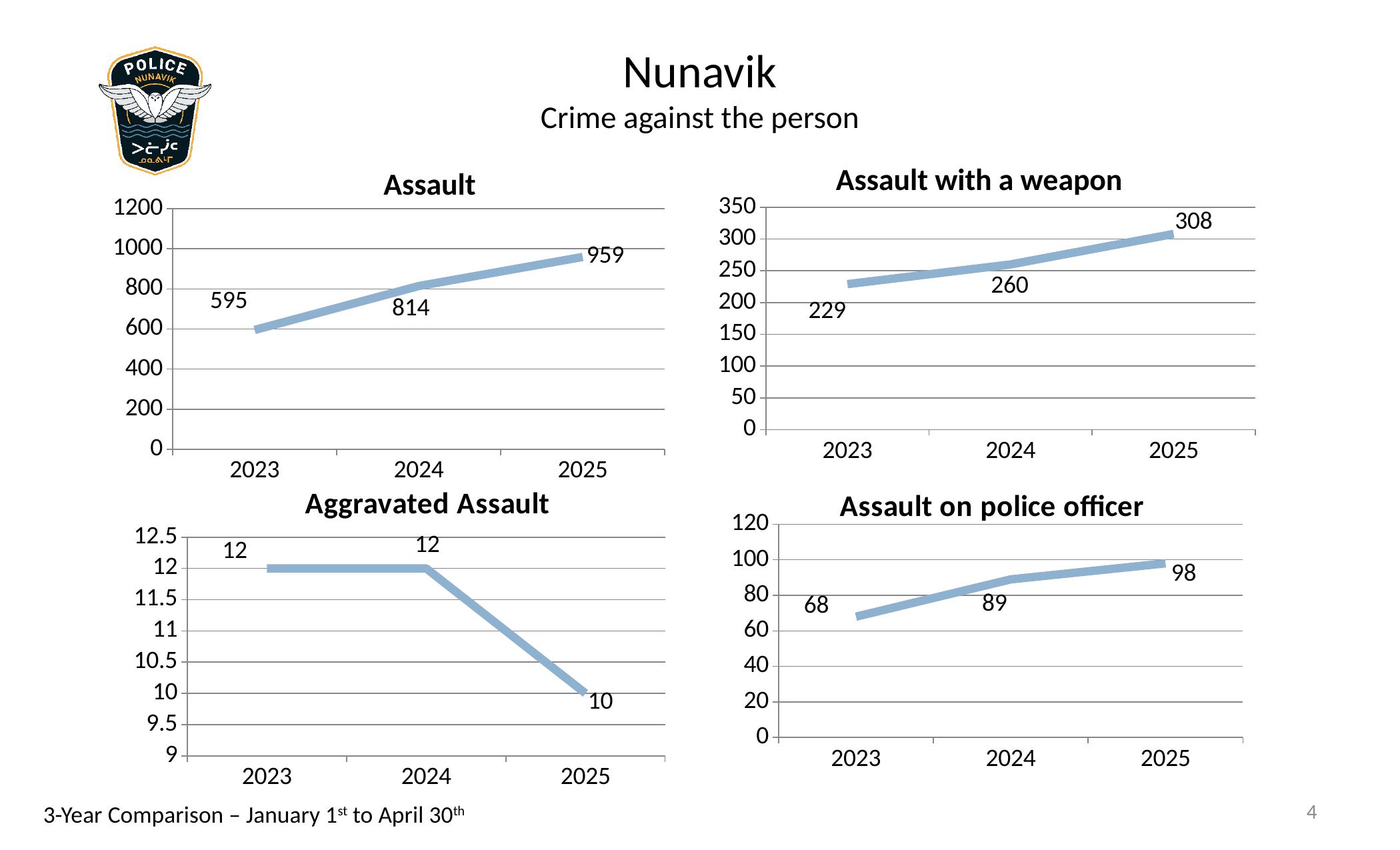
In the 'Assault with a weapon' chart, is the value for 2024 larger or smaller than the value for 2023? larger In the 'Assault' chart, what is the difference between the 2025 and 2023 values? 364 In the 'Assault with a weapon' chart, what is the value for 2023? 229 In the 'Aggravated Assault' chart, what is the value for 2025? 10 How many years are plotted in the 'Assault on police officer' chart? 3 In the 'Assault on police officer' chart, what is the difference between the 2025 and 2024 values? 9 In the 'Assault' chart, which year has the lowest value? 2023 In the 'Assault with a weapon' chart, which year has the highest value? 2025 In the 'Assault on police officer' chart, what is the value for 2024? 89 In the 'Assault' chart, what is the value for 2025? 959 What kind of chart is the 'Assault with a weapon' chart? line chart In the 'Aggravated Assault' chart, do the values rise or fall from 2024 to 2025? fall